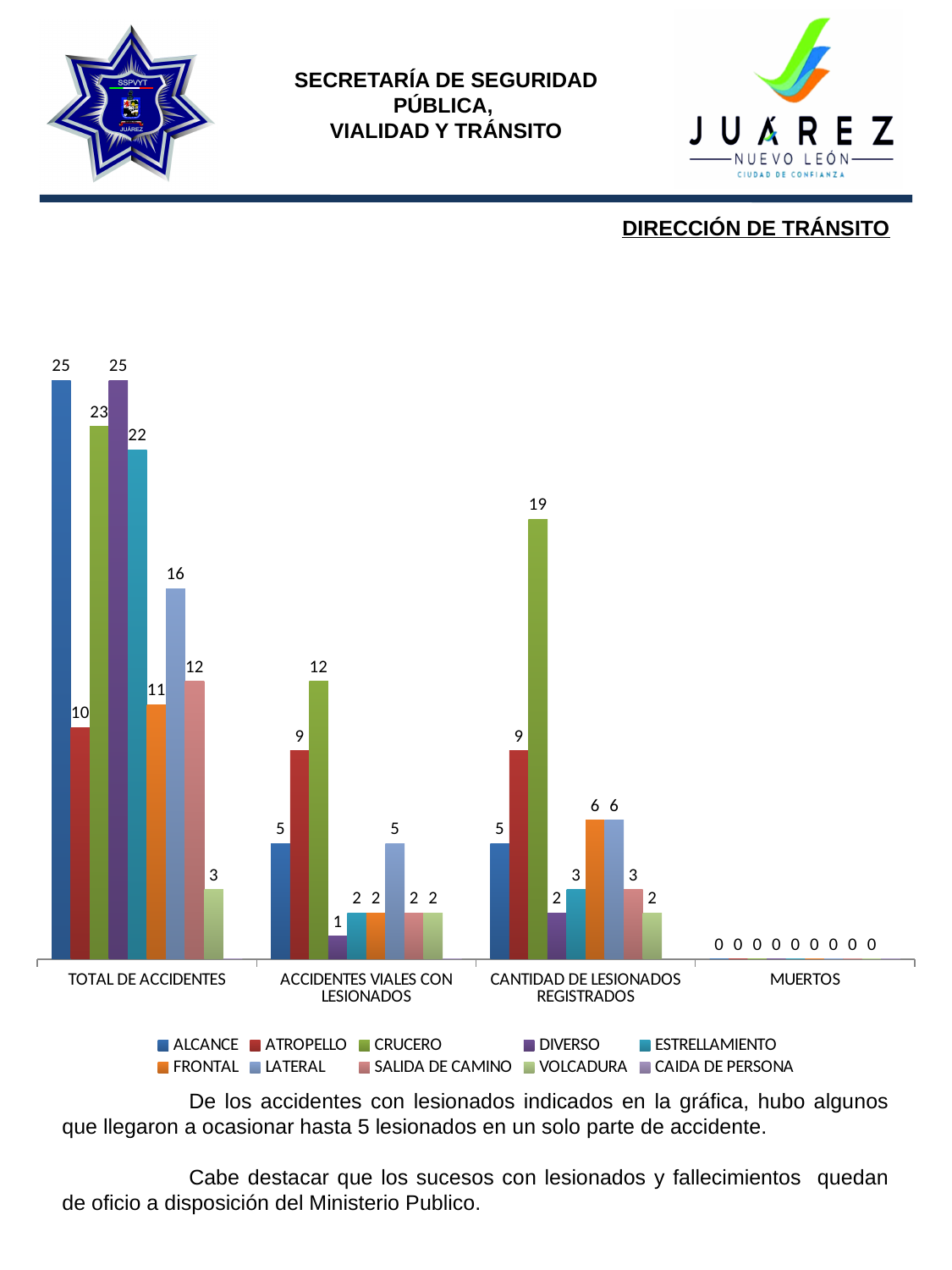
How many series does the legend list? 10 What is the value for FRONTAL in the CANTIDAD DE LESIONADOS REGISTRADOS category? 6 What kind of chart is shown on the slide? bar chart What is the value for LATERAL in the TOTAL DE ACCIDENTES category? 16 What is the value for CRUCERO in the CANTIDAD DE LESIONADOS REGISTRADOS category? 19 What is the value for ALCANCE in the MUERTOS category? 0 In the TOTAL DE ACCIDENTES category, which is larger: CRUCERO or ESTRELLAMIENTO? CRUCERO What is the difference between ALCANCE and ATROPELLO in the TOTAL DE ACCIDENTES category? 15 What is the value for ATROPELLO in the TOTAL DE ACCIDENTES category? 10 Which series has the highest value in the ACCIDENTES VIALES CON LESIONADOS category? CRUCERO How many categories are shown on the x axis? 4